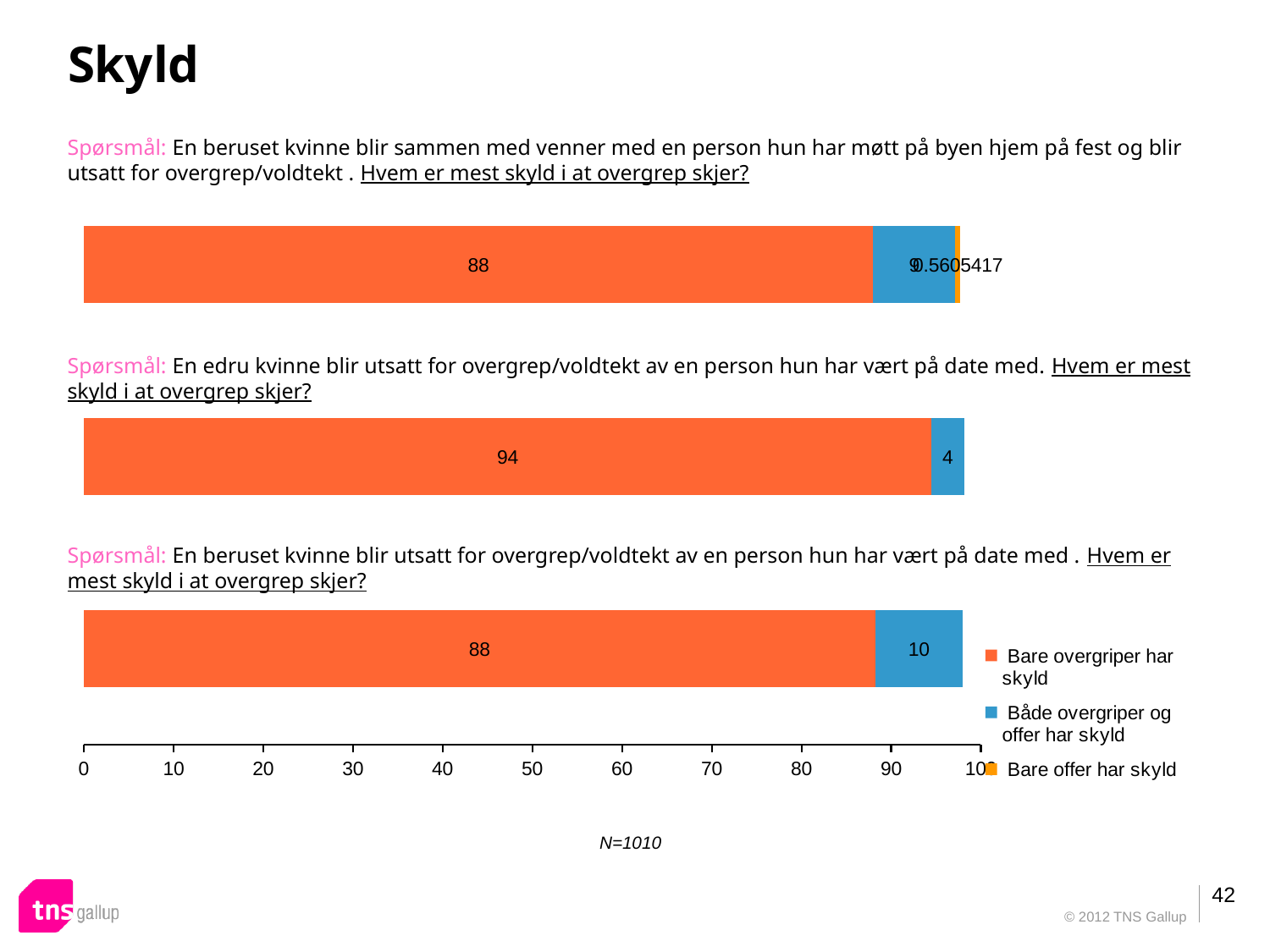
In the middle chart, which category has the highest value? Bare overgriper har skyld In the middle chart, what is the value for 'Bare overgriper har skyld'? 94 How many series does the legend list? 3 What kind of chart is used on this slide? bar chart In the top chart, is the value for 'Bare overgriper har skyld' greater or less than 80? greater In the bottom chart, what is the value for 'Både overgriper og offer har skyld'? 10 Which chart has the larger value for 'Bare overgriper har skyld', the middle chart or the bottom chart? the middle chart In the middle chart, what is the difference between 'Bare overgriper har skyld' and 'Både overgriper og offer har skyld'? 90 In the middle chart, what is the value for 'Både overgriper og offer har skyld'? 4 In the bottom chart, what is the difference between 'Bare overgriper har skyld' and 'Både overgriper og offer har skyld'? 78 In the bottom chart, what is the value for 'Bare overgriper har skyld'? 88 In the top chart, what is the value for 'Bare overgriper har skyld'? 88